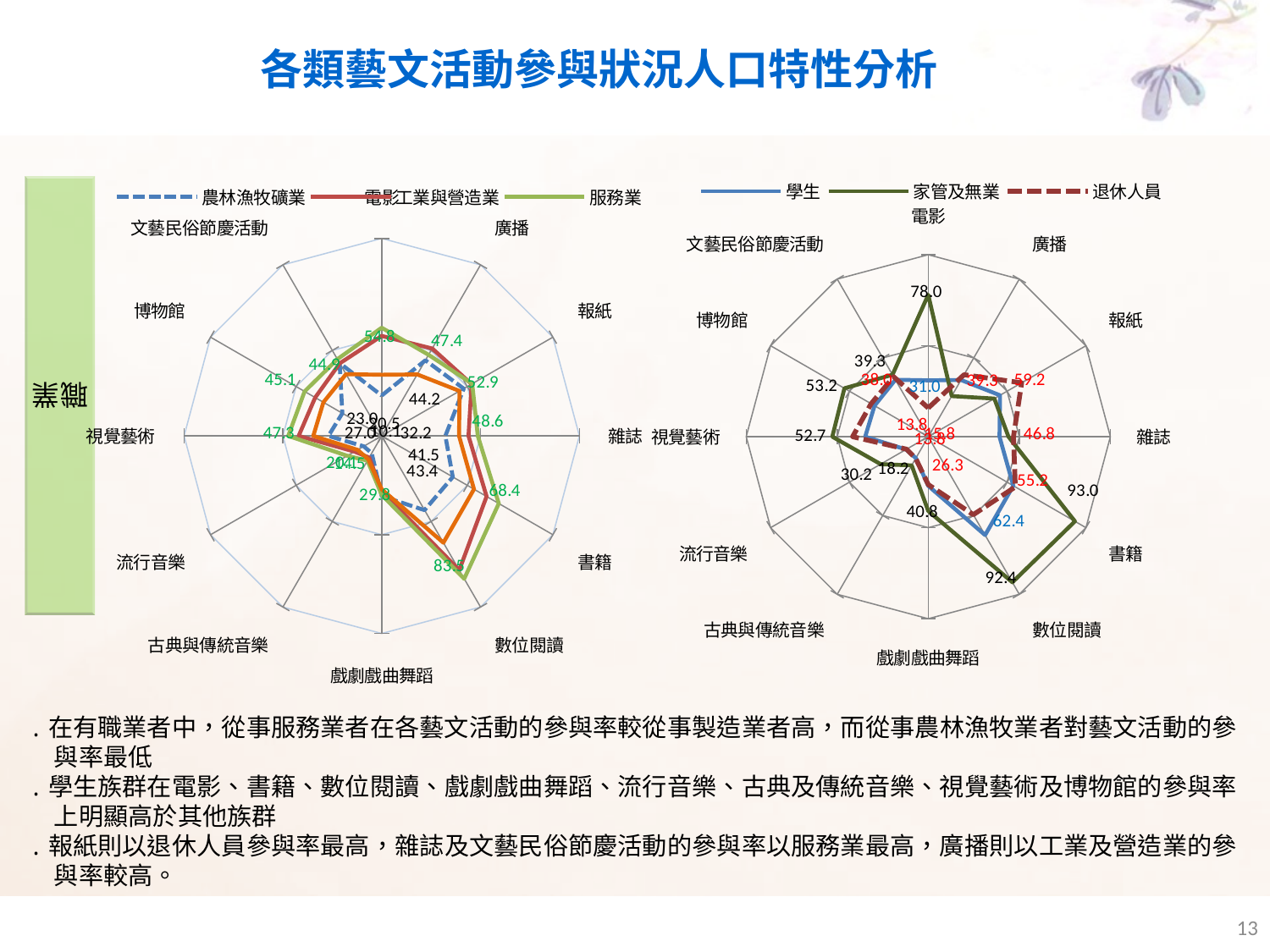
How many series does the legend of the left chart list? 3 In the right chart, what is the value labelled for 退休人員 at 報紙? 59.2 In the right chart, what is the highest value labelled for 書籍? 93.0 In the right chart, what is the difference between the 退休人員 values at 報紙 (59.2) and 雜誌 (46.8)? 12.4 What kind of chart is the left chart on the slide? radar chart How many categories (axes) does the right chart have? 12 In the right chart, what is the highest value labelled for 電影? 78.0 Which three groups are listed in the legend of the right chart? 學生, 家管及無業, 退休人員 In the left chart, what is the value for 服務業 at 書籍? 68.4 How many series does the legend of the right chart list? 3 In the left chart, what is the value for 服務業 at 數位閱讀? 83.5 In the left chart, which category has the highest value for 服務業? 數位閱讀